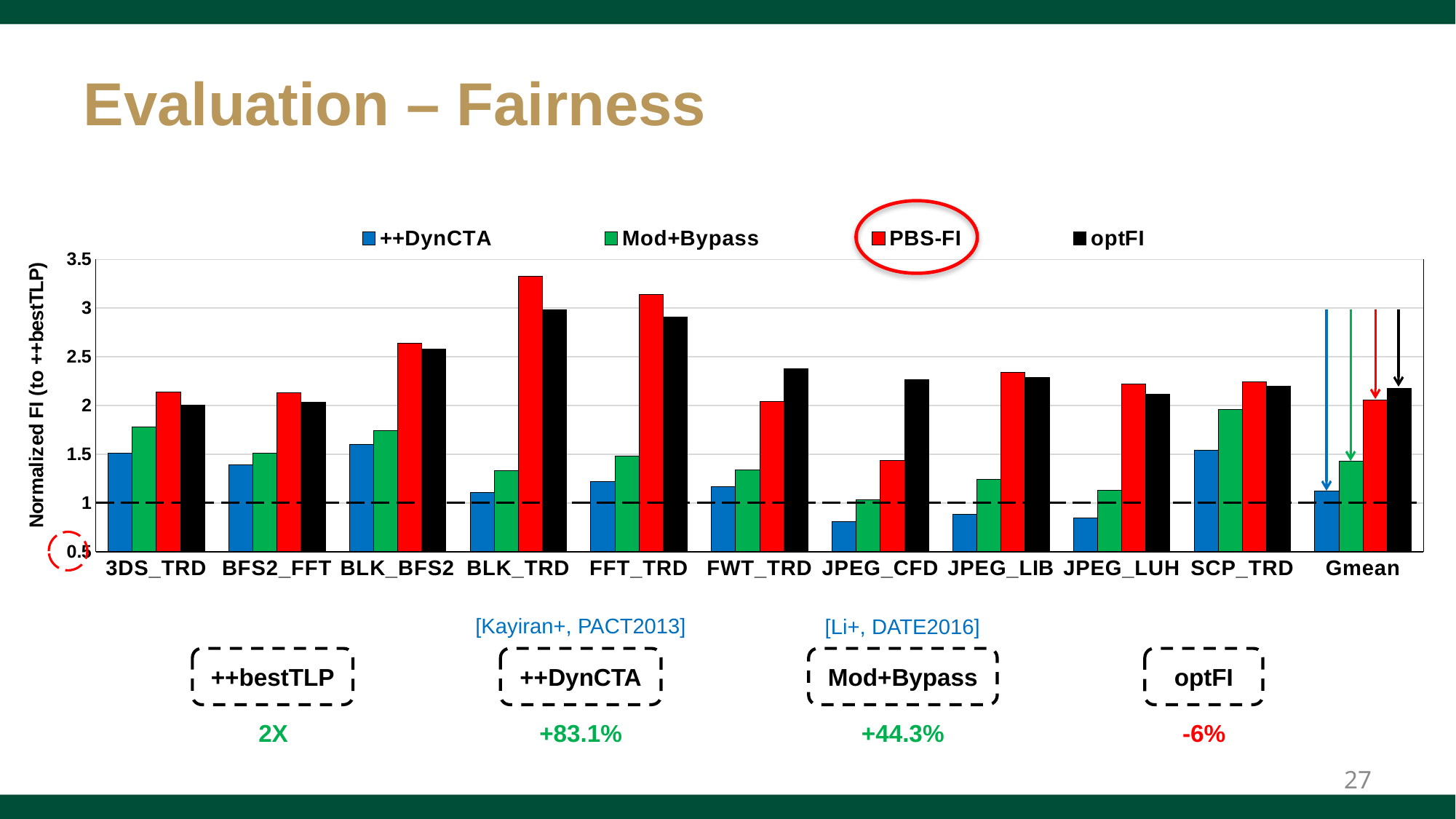
What kind of chart is shown on the slide? bar chart For FWT_TRD, which is larger: the PBS-FI value or the optFI value? optFI Which category has the highest PBS-FI value? BLK_TRD How many series does the chart legend list? 4 Is the Mod+Bypass value for SCP_TRD greater or less than 1.5? greater Is the ++DynCTA value for JPEG_CFD greater or less than 1? less Is the optFI value for FWT_TRD greater or less than 2? greater What is the title of the chart's y axis? Normalized FI (to ++bestTLP) For 3DS_TRD, which is larger: the ++DynCTA value or the Mod+Bypass value? Mod+Bypass Which category has the lowest PBS-FI value? JPEG_CFD How many categories are shown along the x axis of the chart? 11